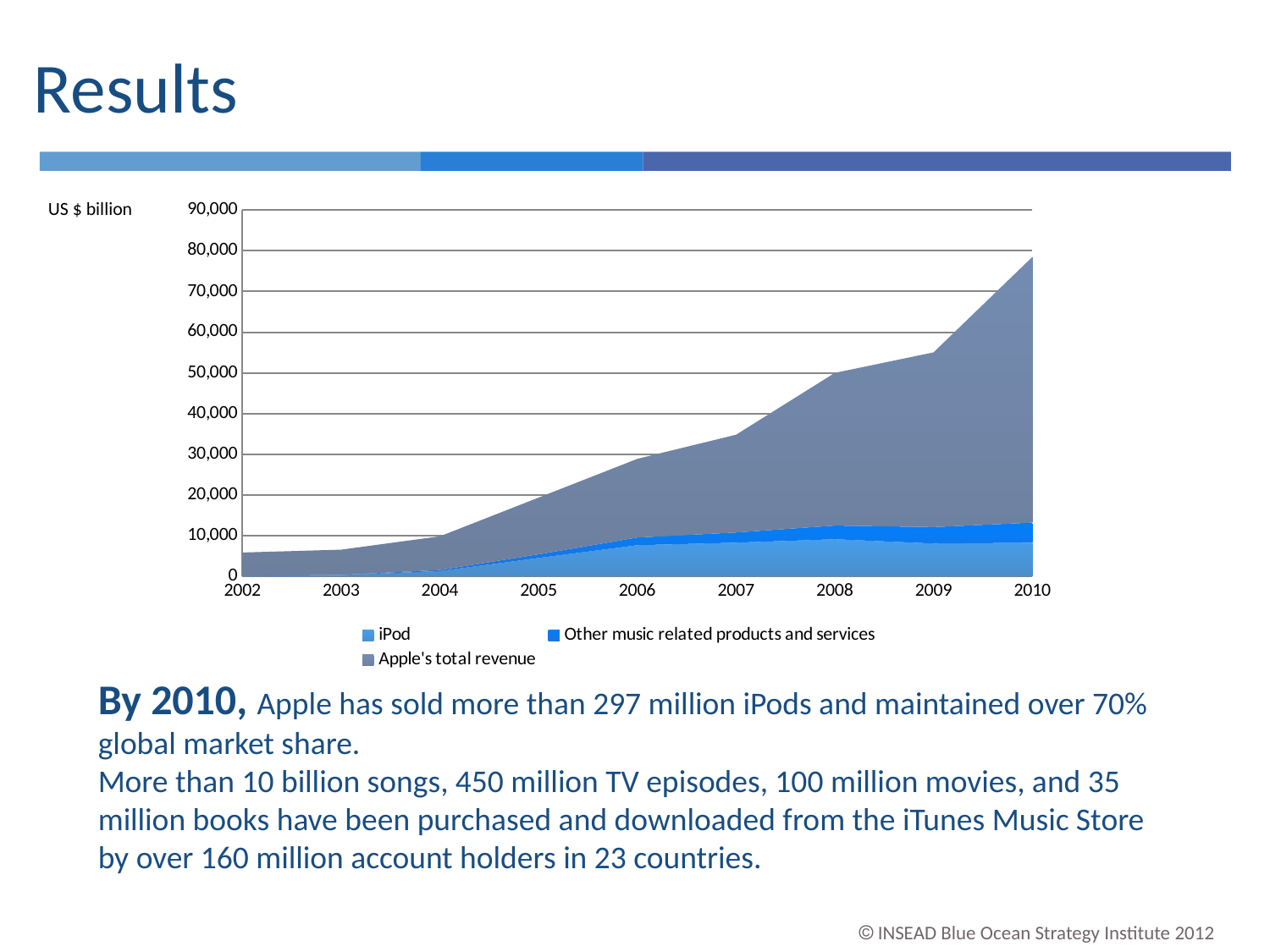
How many series does the chart's legend list? 3 What kind of chart is shown on the slide? Area chart In which year is the total height of the stacked area highest? 2010 Does the total height of the stacked area rise or fall from 2002 to 2010? Rise Which series is listed first in the chart's legend? iPod Is the total height of the stacked area in 2006 greater or less than 40,000? less What unit label is shown next to the chart's vertical axis? US $ billion Is the total height of the stacked area larger in 2008 or in 2005? 2008 Is the total height of the stacked area in 2009 greater or less than 50,000? greater Is the total height of the stacked area in 2010 greater or less than 70,000? greater How many years are plotted along the x axis of the chart? 9